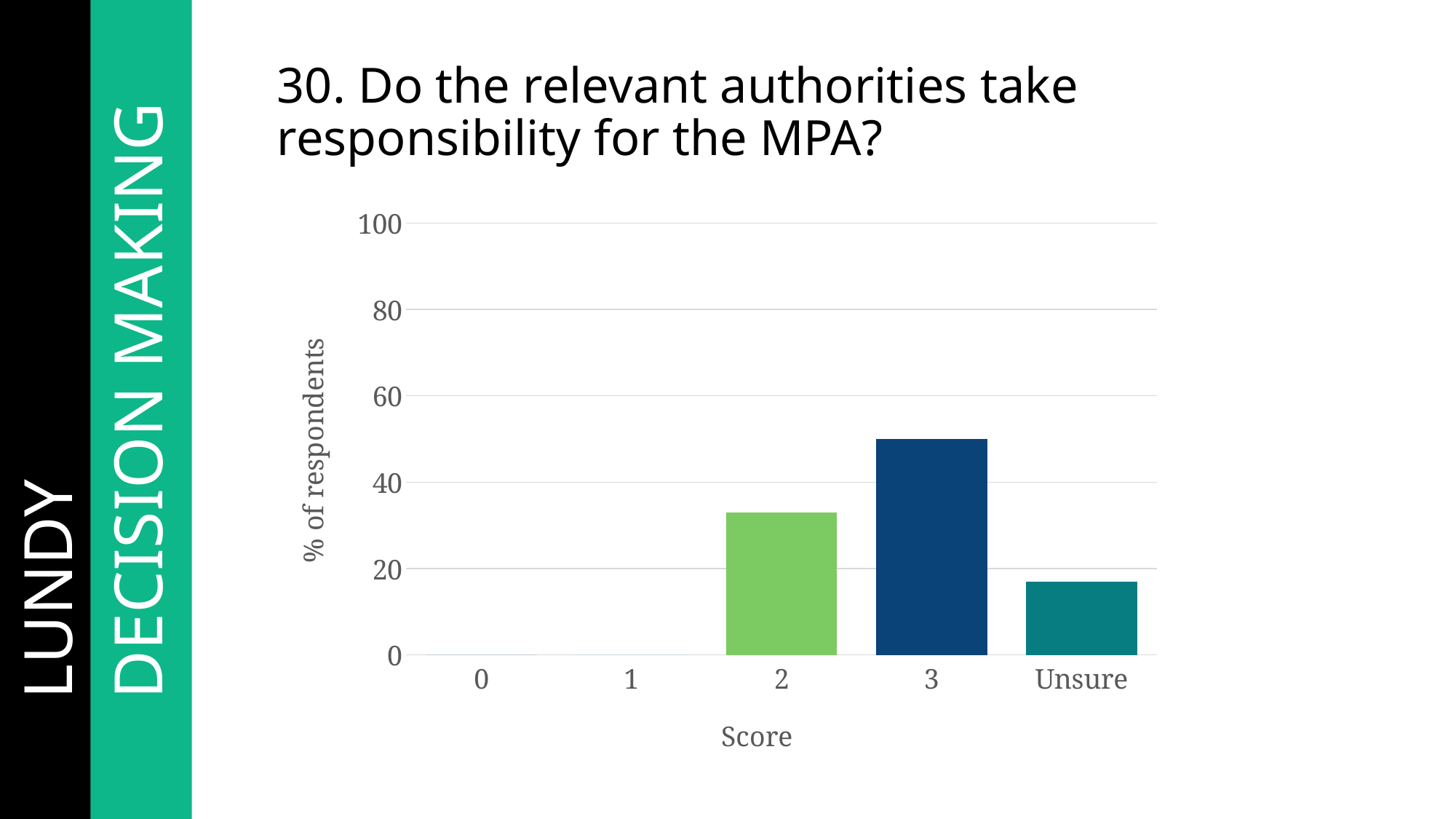
What is the value for score 0? 0 What is the value for score 1? 0 Which score category has the highest percentage of respondents? 3 How many categories are shown on the x axis of the chart? 5 Is the value for score 2 greater or less than 40? less Is the value for score 2 greater or less than 20? greater Is the value for score 3 greater or less than 60? less What is the label on the y axis of the chart? % of respondents What kind of chart is shown on the slide? bar chart Which is larger, the value for score 2 or the value for Unsure? score 2